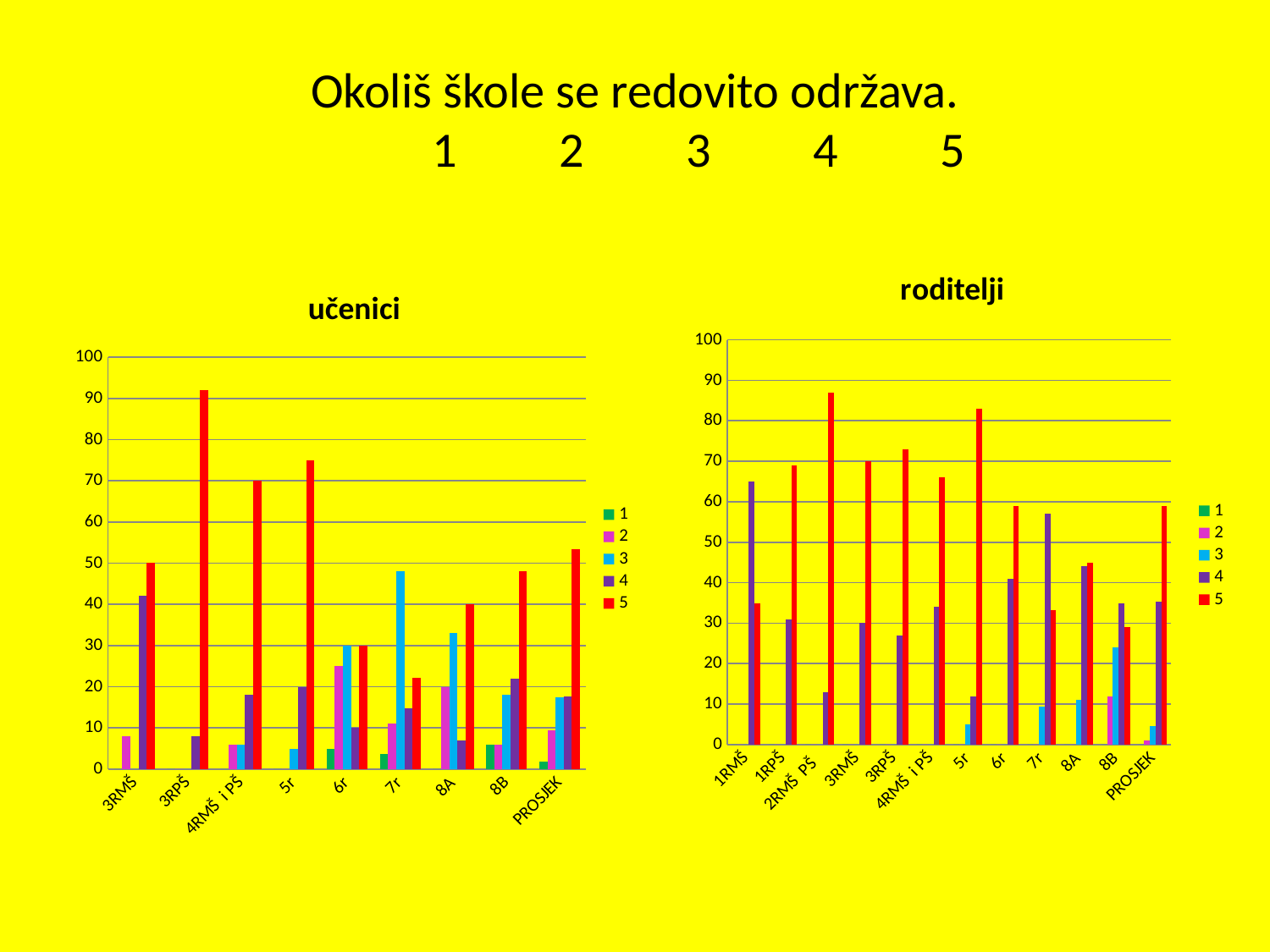
What colour are the bars for series 5 in the left chart titled "učenici"? red In the right chart titled "roditelji", which category has the tallest bar for series 5? 2RMŠ PŠ In the right chart titled "roditelji", which is larger for series 5: the value for 5r or the value for 7r? 5r How many categories are shown on the x axis of the right chart titled "roditelji"? 12 How many series does the legend of the right chart titled "roditelji" list? 5 What kind of chart is the left chart titled "učenici"? bar chart In the left chart titled "učenici", is the value of series 5 for 7r greater or less than 30? less In the right chart titled "roditelji", is the value of series 4 for 1RMŠ greater or less than 60? greater In the right chart titled "roditelji", is the value of series 5 for 8B greater or less than 40? less How many categories are shown on the x axis of the left chart titled "učenici"? 9 In the left chart titled "učenici", which category has the tallest bar for series 5? 3RPŠ